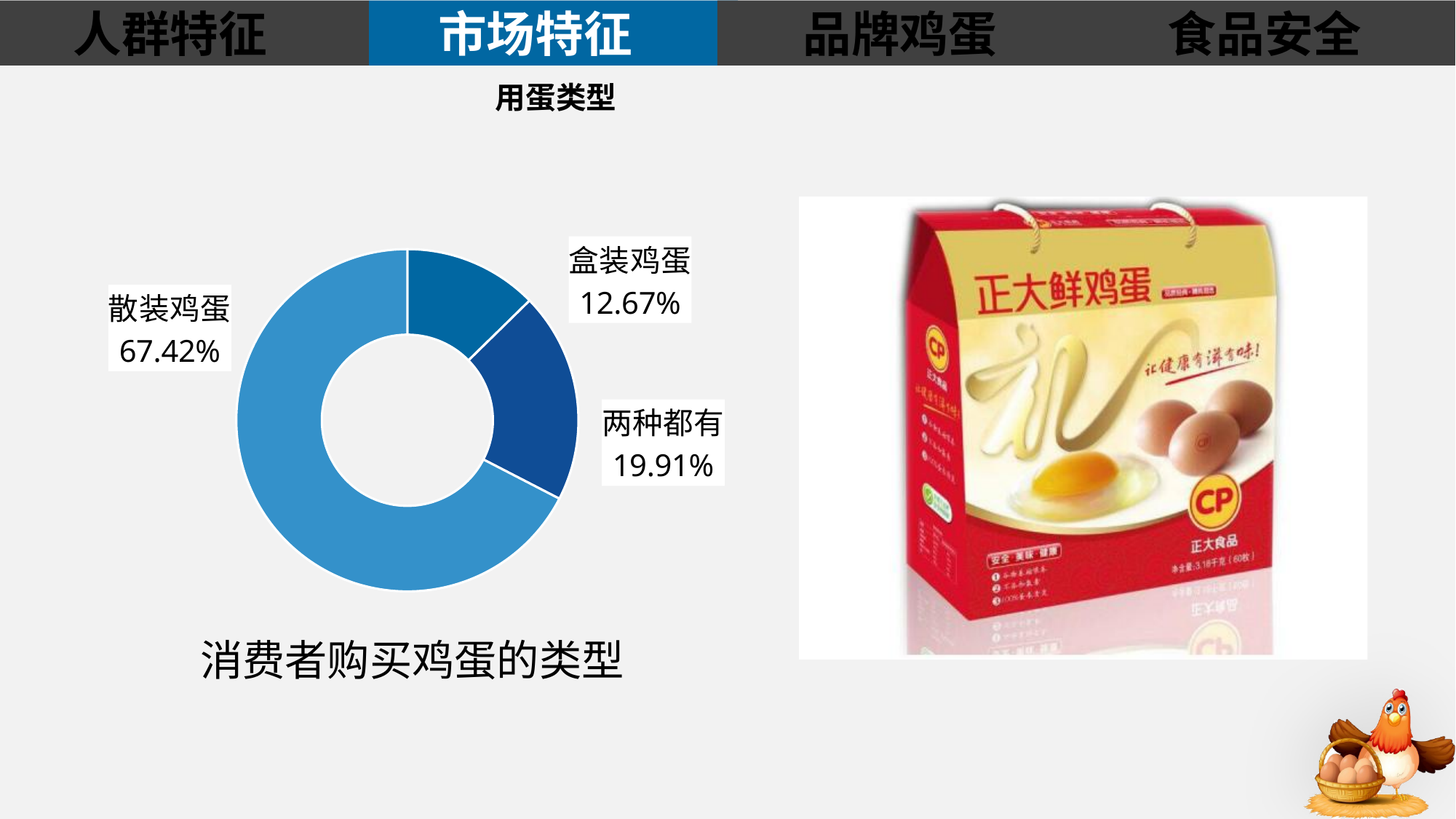
Which category has the smallest share of the pie? 盒装鸡蛋 What kind of chart is shown on the slide? Pie chart (doughnut) Which category has the largest share of the pie? 散装鸡蛋 What is the heading above the chart? 用蛋类型 What is the value shown for 盒装鸡蛋? 12.67% What share of the pie does 散装鸡蛋 account for? 67.42% What is the difference between the shares of 两种都有 and 盒装鸡蛋? 7.24% Which is larger, the share for 两种都有 or the share for 盒装鸡蛋? 两种都有 What is the difference between the shares of 散装鸡蛋 and 两种都有? 47.51% How many categories are shown in the chart? 3 What is the caption below the chart? 消费者购买鸡蛋的类型 What is the value shown for 两种都有? 19.91%